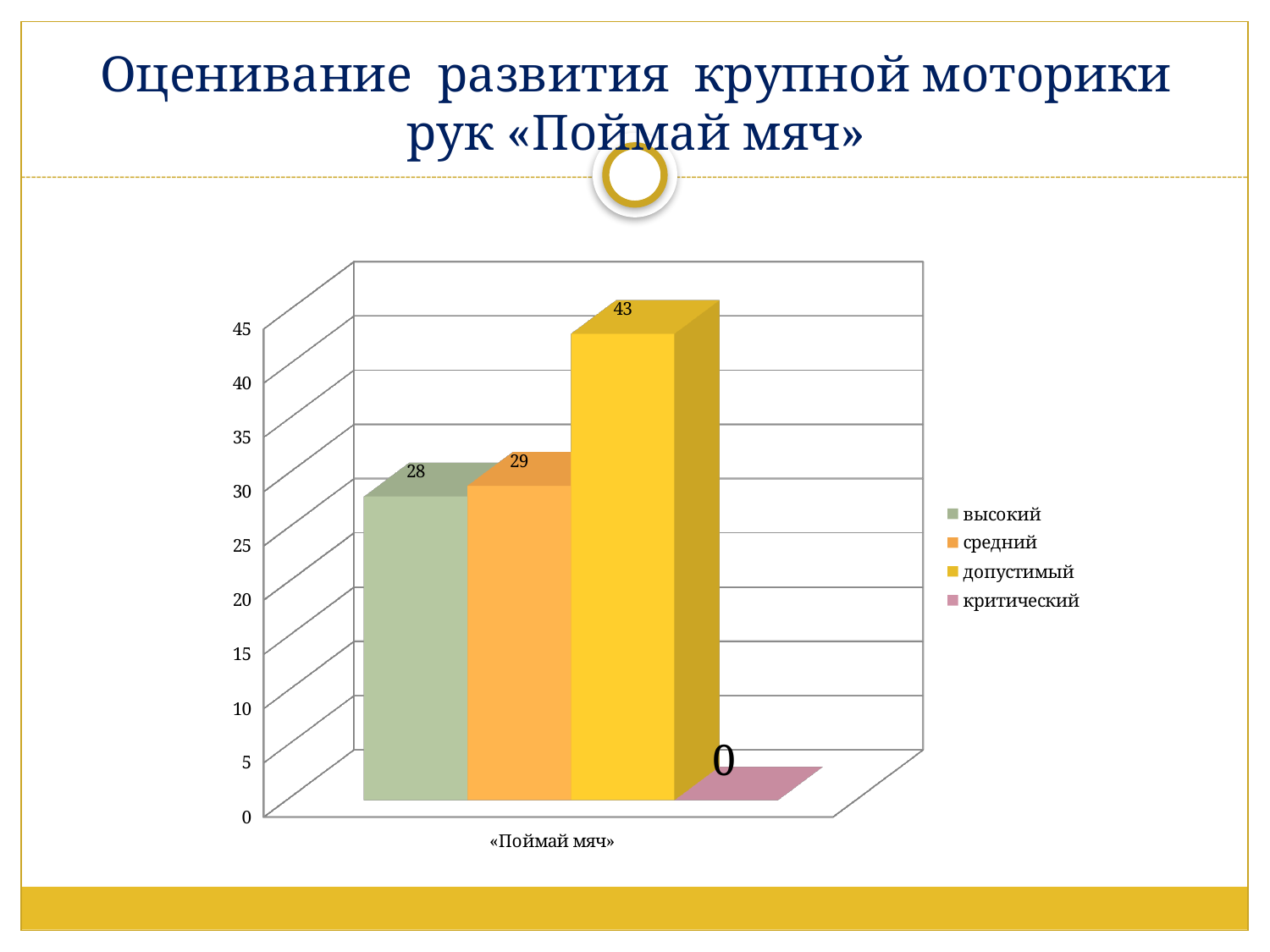
What kind of chart is shown on the slide? bar chart What is the value for the «критический» series? 0 Which series has the lowest value? критический Which series has the highest value? допустимый What is the category label shown on the x axis? «Поймай мяч» Which is larger, the value for «допустимый» or the value for «средний»? допустимый What is the difference between the «средний» and «высокий» values? 1 How many series does the legend list? 4 What is the value for the «допустимый» series? 43 What is the value for the «высокий» series in the «Поймай мяч» chart? 28 What is the difference between the «допустимый» and «высокий» values? 15 What is the value for the «средний» series? 29